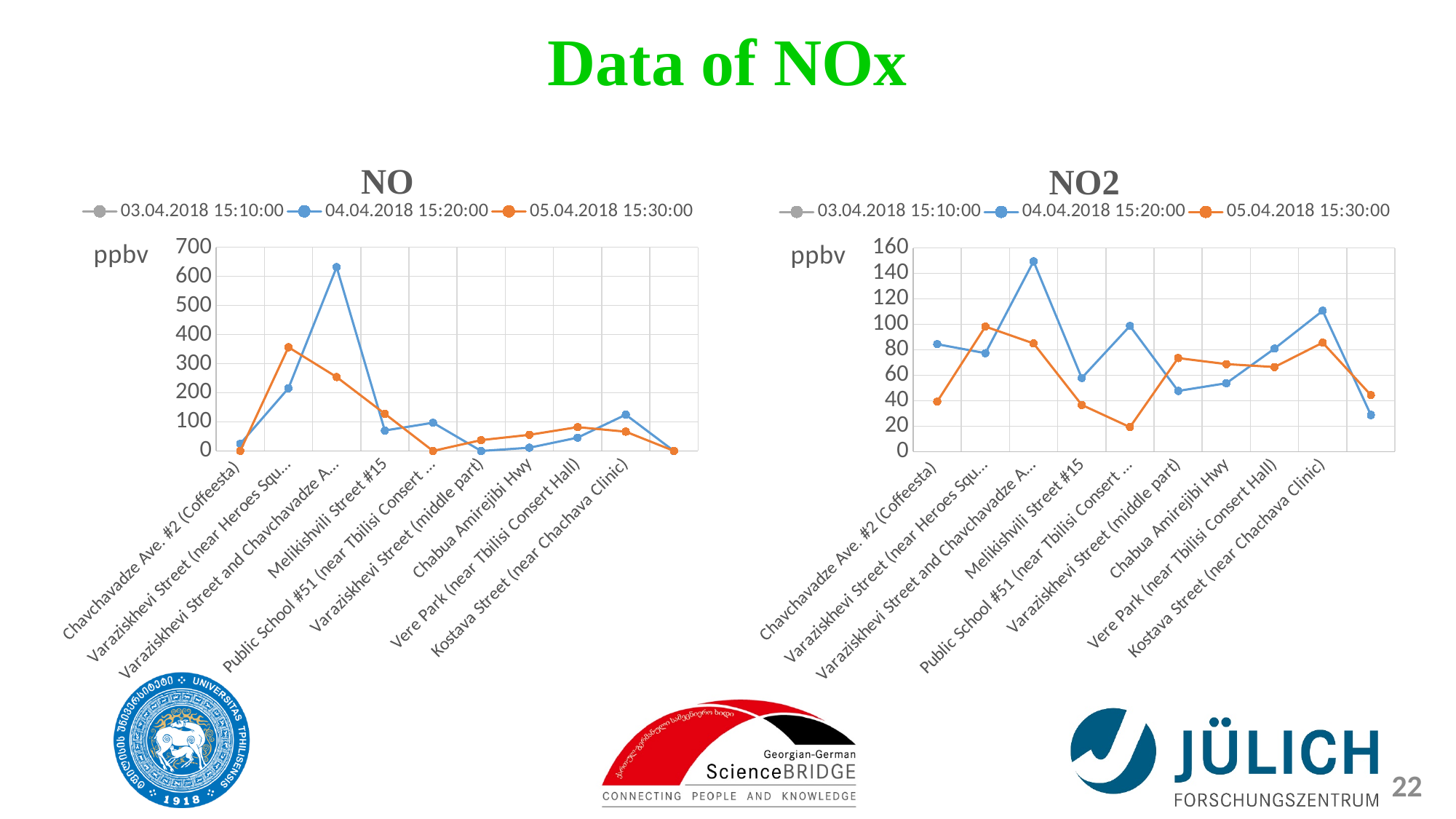
What unit is shown on the y axis of the NO2 chart? ppbv In the NO2 chart, at which location does the 04.04.2018 15:20:00 series reach its highest value? Varaziskhevi Street and Chavchavadze A... In the NO chart, at Varaziskhevi Street and Chavchavadze A..., which series has the larger value: 04.04.2018 15:20:00 or 05.04.2018 15:30:00? 04.04.2018 15:20:00 In the NO chart, at which location does the 04.04.2018 15:20:00 series reach its highest value? Varaziskhevi Street and Chavchavadze A... How many locations are shown on the x axis of the NO chart? 9 In the NO chart, is the 05.04.2018 15:30:00 value for Varaziskhevi Street (near Heroes Squ...) greater or less than 300? greater How many series does the legend of the NO2 chart list? 3 In the NO2 chart, is the 04.04.2018 15:20:00 value for Varaziskhevi Street and Chavchavadze A... greater or less than 140? greater What kind of chart is the NO chart? line chart In the NO2 chart, at which location does the 05.04.2018 15:30:00 series have its lowest value? Public School #51 (near Tbilisi Consert ...) In the NO2 chart, at Chavchavadze Ave. #2 (Coffeesta), which series has the larger value: 04.04.2018 15:20:00 or 05.04.2018 15:30:00? 04.04.2018 15:20:00 In the NO chart, is the 04.04.2018 15:20:00 value for Varaziskhevi Street and Chavchavadze A... greater or less than 600? greater